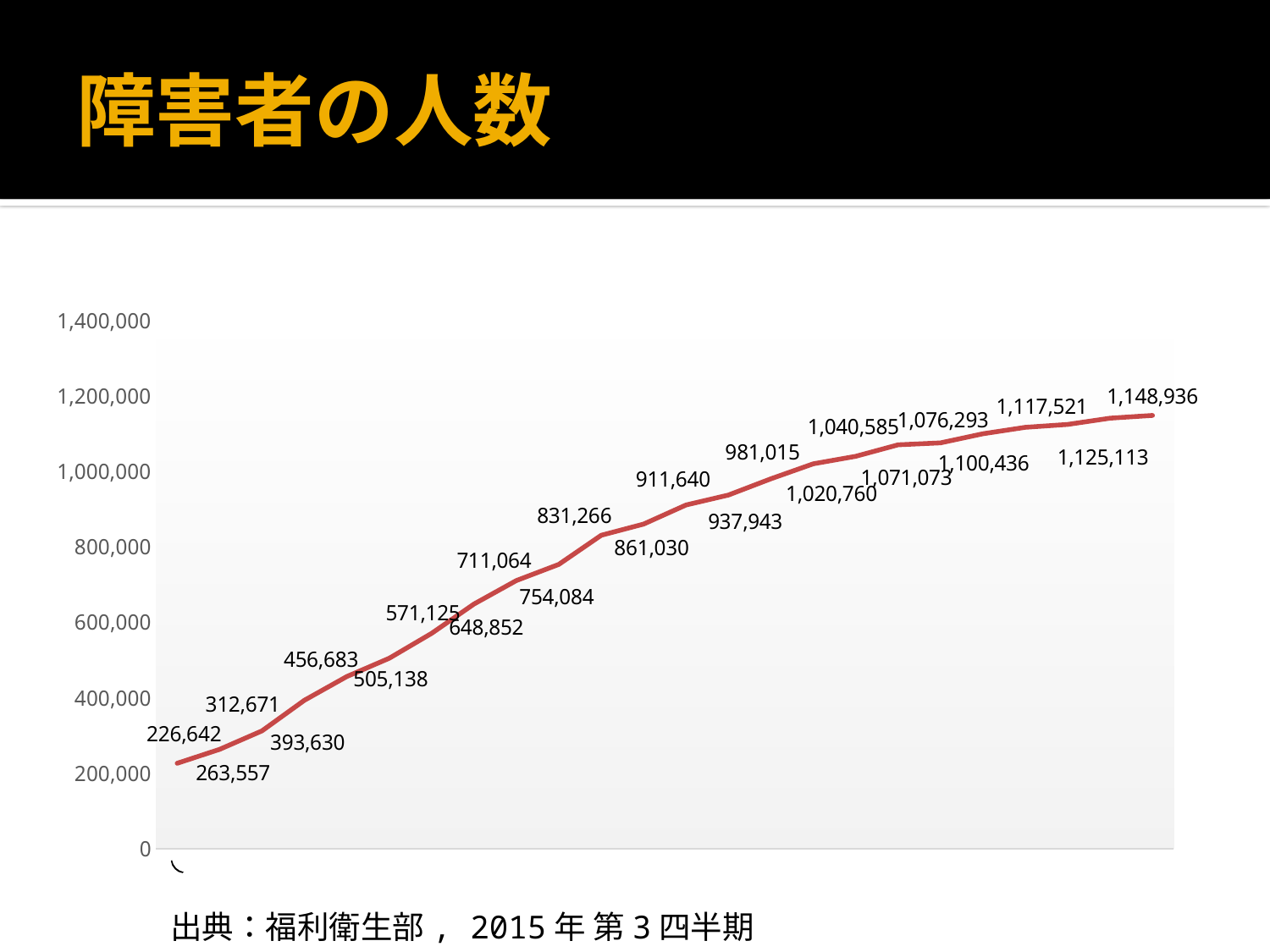
Do the values rise or fall along the x axis? rise What is the value of the first data point on the line? 226,642 Which is larger, the first data point or the last data point on the line? the last data point What kind of chart is shown on the slide? line chart Is the value of the last data point greater or less than 1,000,000? greater Is the value of the first data point greater or less than 400,000? less What is the difference between the last data point (1,148,936) and the first data point (226,642)? 922,294 What is the lowest value plotted on the chart? 226,642 What is the highest value plotted on the chart? 1,148,936 What is the value of the last data point on the line? 1,148,936 How many data points are plotted on the line? 24 What is the title of the slide containing the chart? 障害者の人数